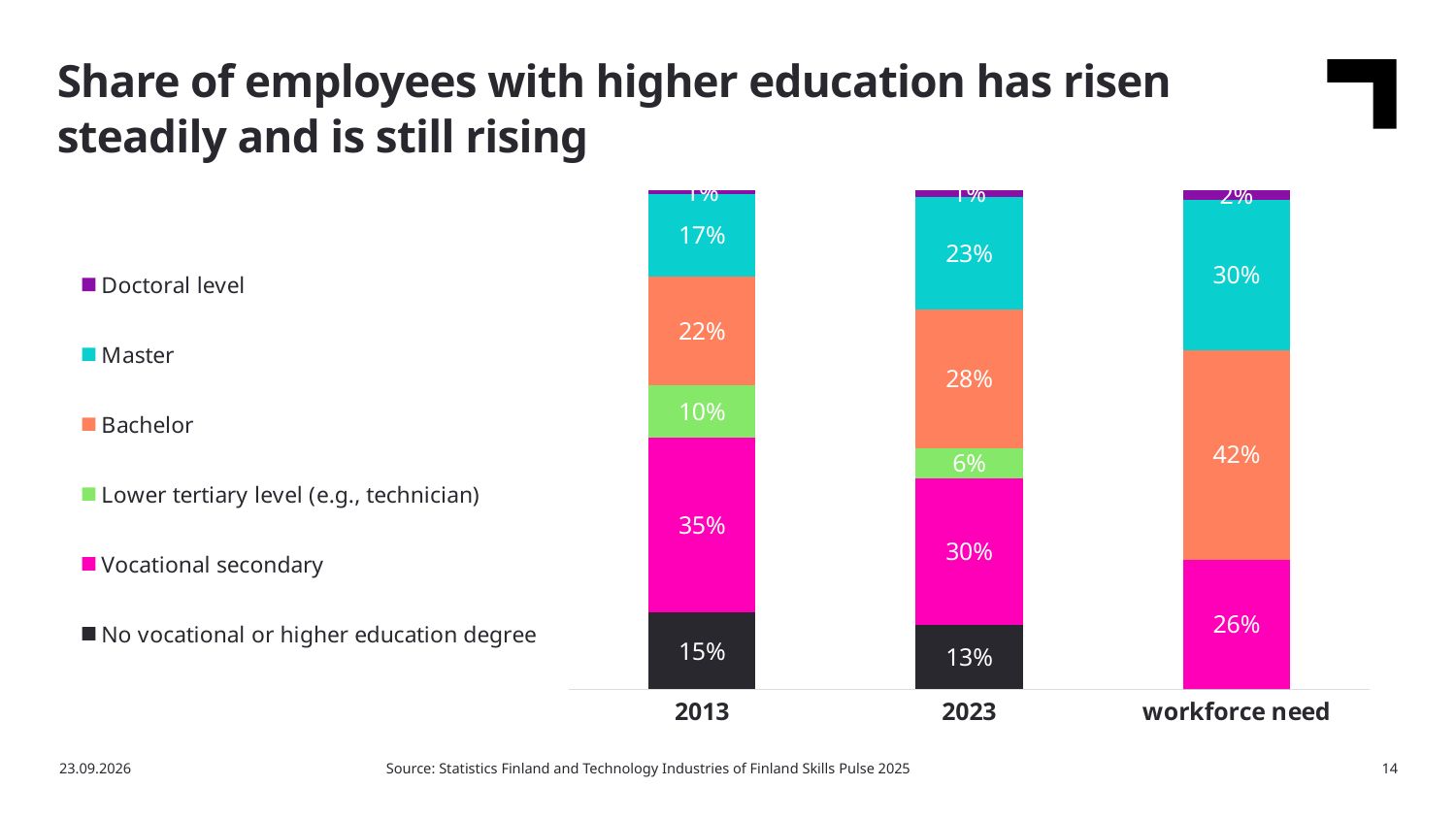
Which bar has the highest Bachelor share? workforce need How many bars are shown on the x axis? 3 What is the share with no vocational or higher education degree in 2023? 13% By how many percentage points did the Master share increase from 2013 to 2023? 6 percentage points Which year has the larger Vocational secondary share, 2013 or 2023? 2013 How many series does the legend list? 6 What is the Master share for 2023? 23% What is the Vocational secondary share for 2013? 35% What kind of chart is shown on the slide? Stacked bar chart Does the Master share rise or fall from 2013 through 2023 to workforce need? Rises What is the Lower tertiary level share for 2023? 6% What is the Bachelor share in the workforce need bar? 42%